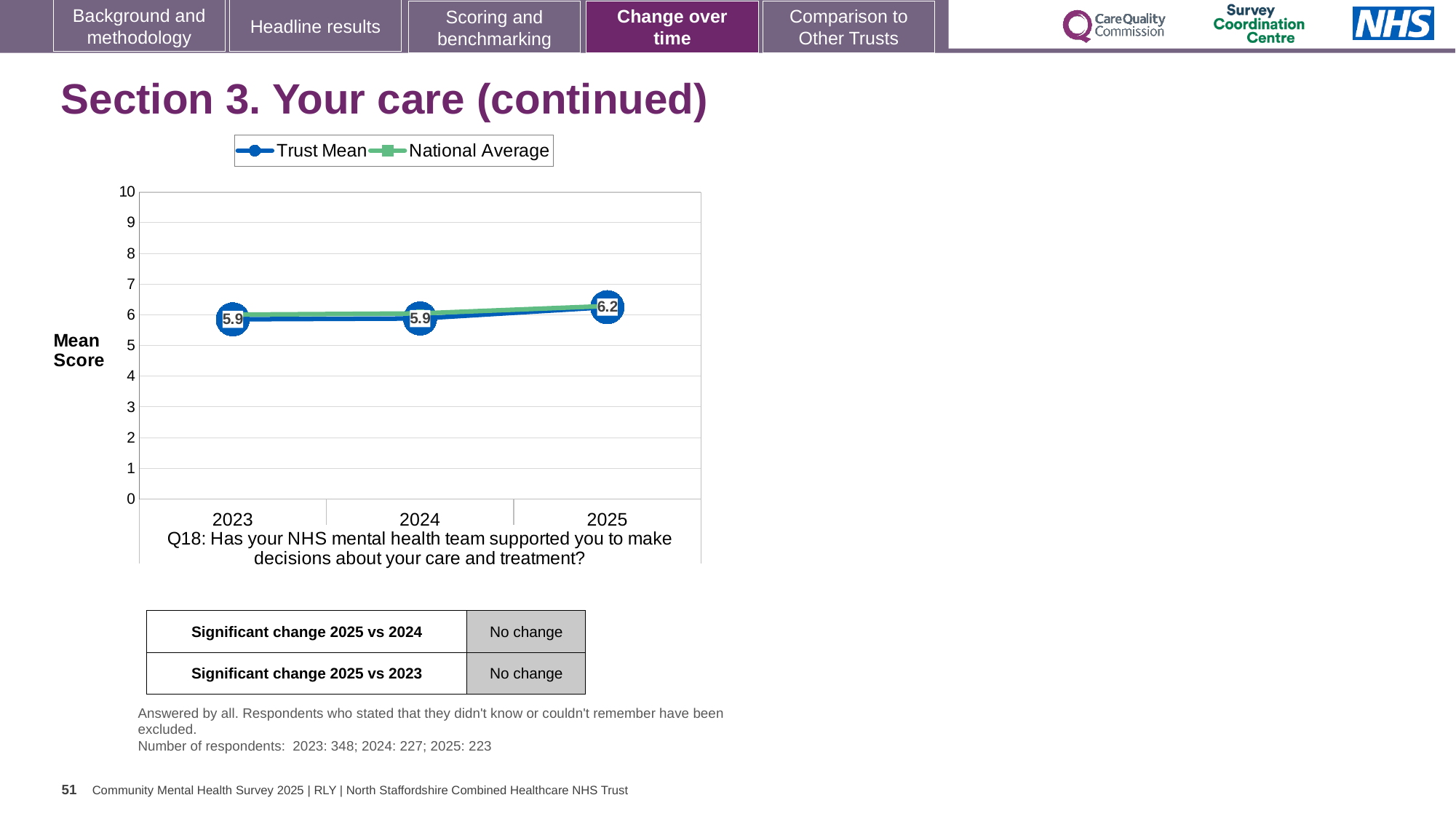
What is the Trust Mean score for 2024? 5.9 Is the National Average value for 2025 greater or less than 7? less How many years are plotted on the x axis of the chart? 3 Which year has the larger Trust Mean score, 2024 or 2025? 2025 Does the Trust Mean score rise or fall from 2023 to 2025? Rise What is the difference between the Trust Mean score in 2025 and in 2023? 0.3 What is the Trust Mean score for 2023? 5.9 What kind of chart is shown on the slide? Line chart What is the Trust Mean score for 2025? 6.2 In which year is the Trust Mean score highest? 2025 How many series does the chart legend list? 2 Is the Trust Mean score for 2023 greater or less than 5? greater